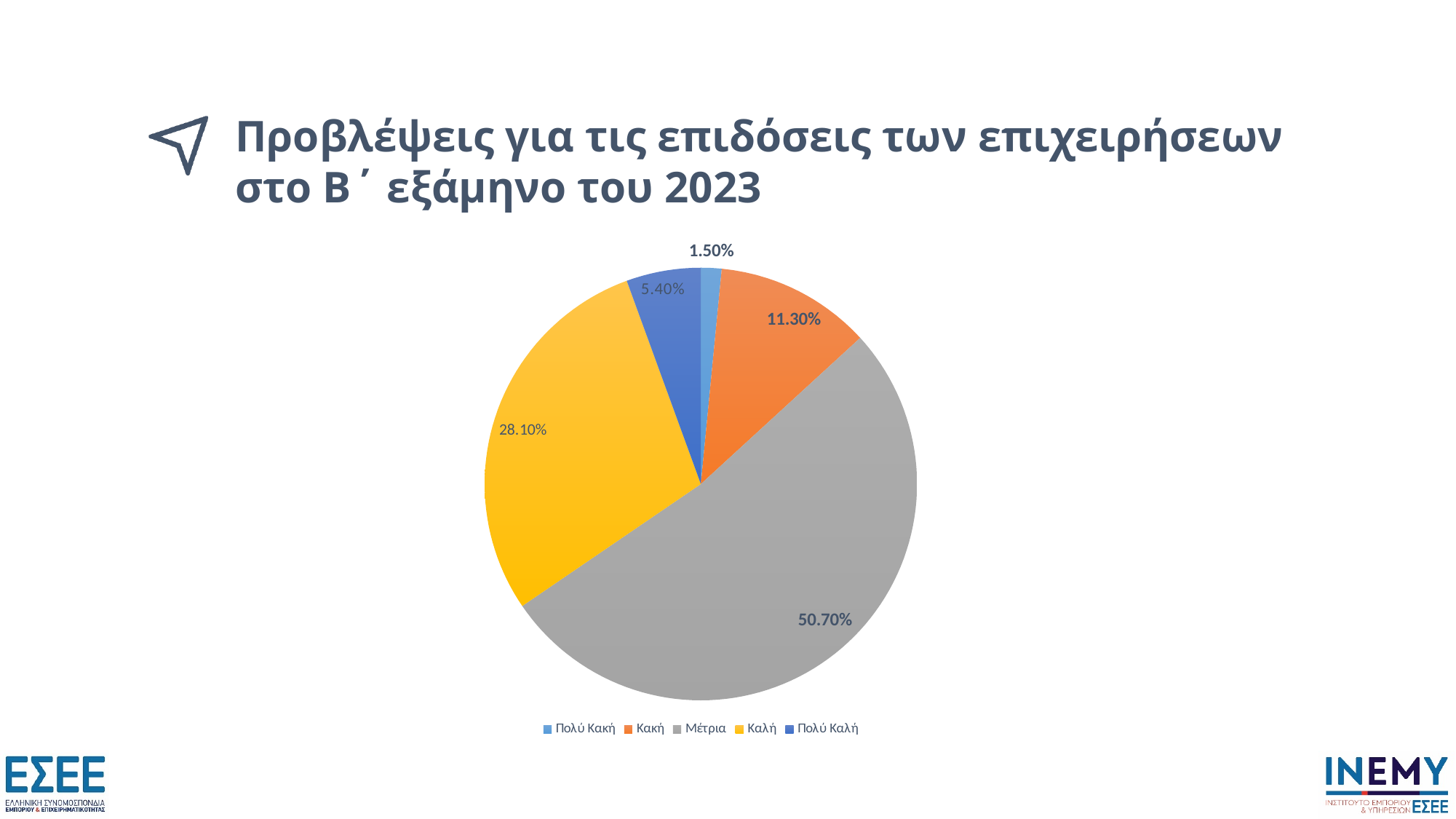
What kind of chart is shown on the slide? Pie chart What share of the pie does Μέτρια hold? 50.70% What is the difference between the values for Μέτρια and Καλή? 22.60% What is the value for Κακή? 11.30% What is the value for Πολύ Καλή? 5.40% How many categories does the pie chart have? 5 Which is larger, the value for Κακή or the value for Πολύ Καλή? Κακή What is the value for Πολύ Κακή? 1.50% Which category has the smallest slice of the pie? Πολύ Κακή What is the value for Καλή? 28.10% What colour is the Καλή slice? Yellow Which category has the largest slice of the pie? Μέτρια